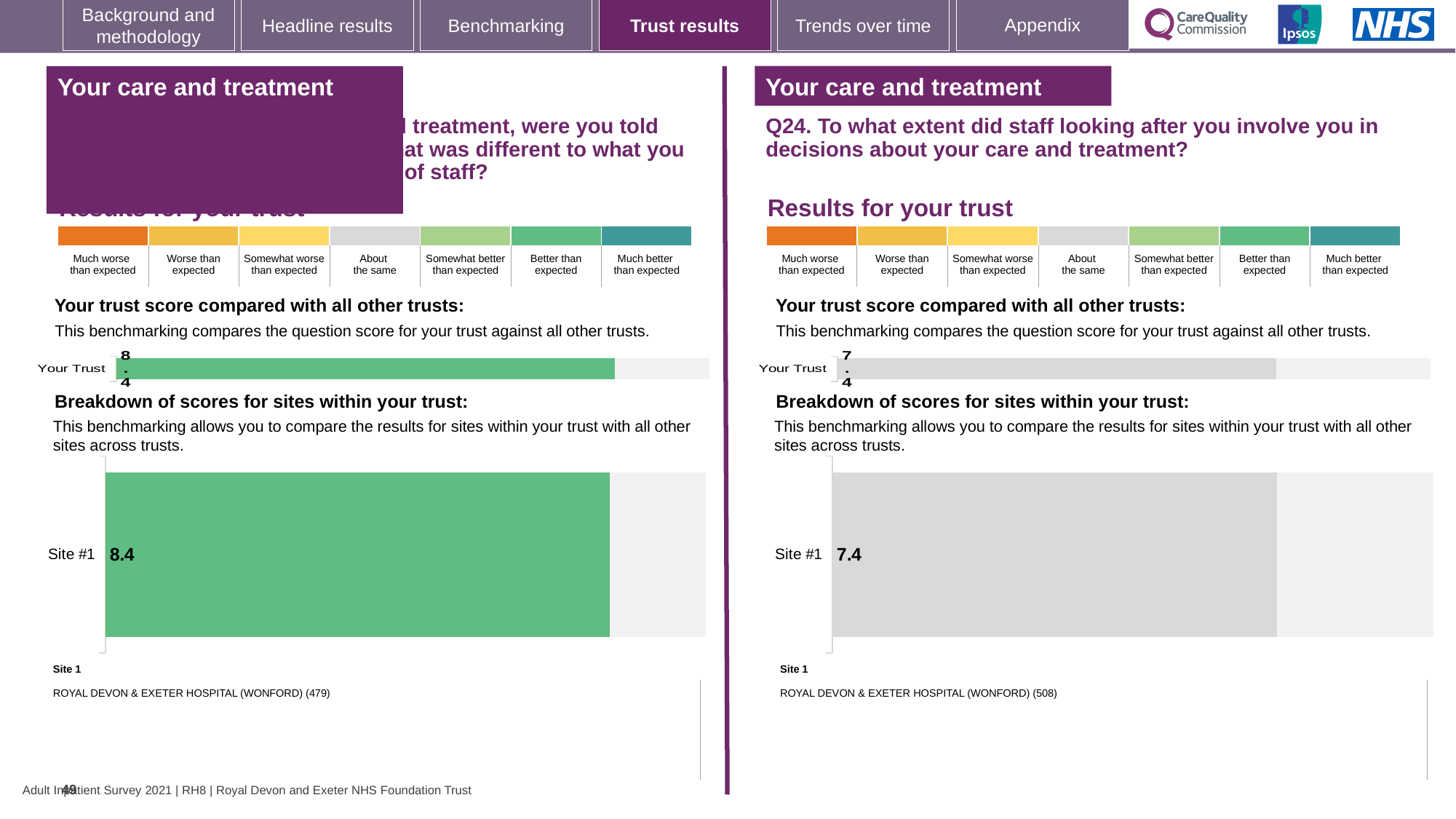
How many sites are shown in the site breakdown on the right-hand chart for Q24? 1 What is the difference between the Site #1 score on the left-hand chart and the Site #1 score on the right-hand chart for Q24? 1.0 On the right-hand chart for Q24, what is the score shown for Site #1? 7.4 On the right-hand chart for Q24, which benchmark category does the grey colour of the Site #1 bar correspond to? About the same On the right-hand chart for Q24, what is the score shown for Your Trust? 7.4 On the left-hand chart, what is the score shown for Your Trust? 8.4 What kind of chart is used to show the Site #1 score on the right-hand chart for Q24? Bar chart On the left-hand chart, which benchmark category does the green colour of the Site #1 bar correspond to? Better than expected On the left-hand chart, what is the score shown for Site #1? 8.4 Which site is listed as Site 1 on the right-hand chart for Q24? ROYAL DEVON & EXETER HOSPITAL (WONFORD) (508) Which is larger: the Site #1 score on the left-hand chart or the Site #1 score on the right-hand chart for Q24? Left-hand chart (8.4) How many sites are shown in the site breakdown on the left-hand chart? 1